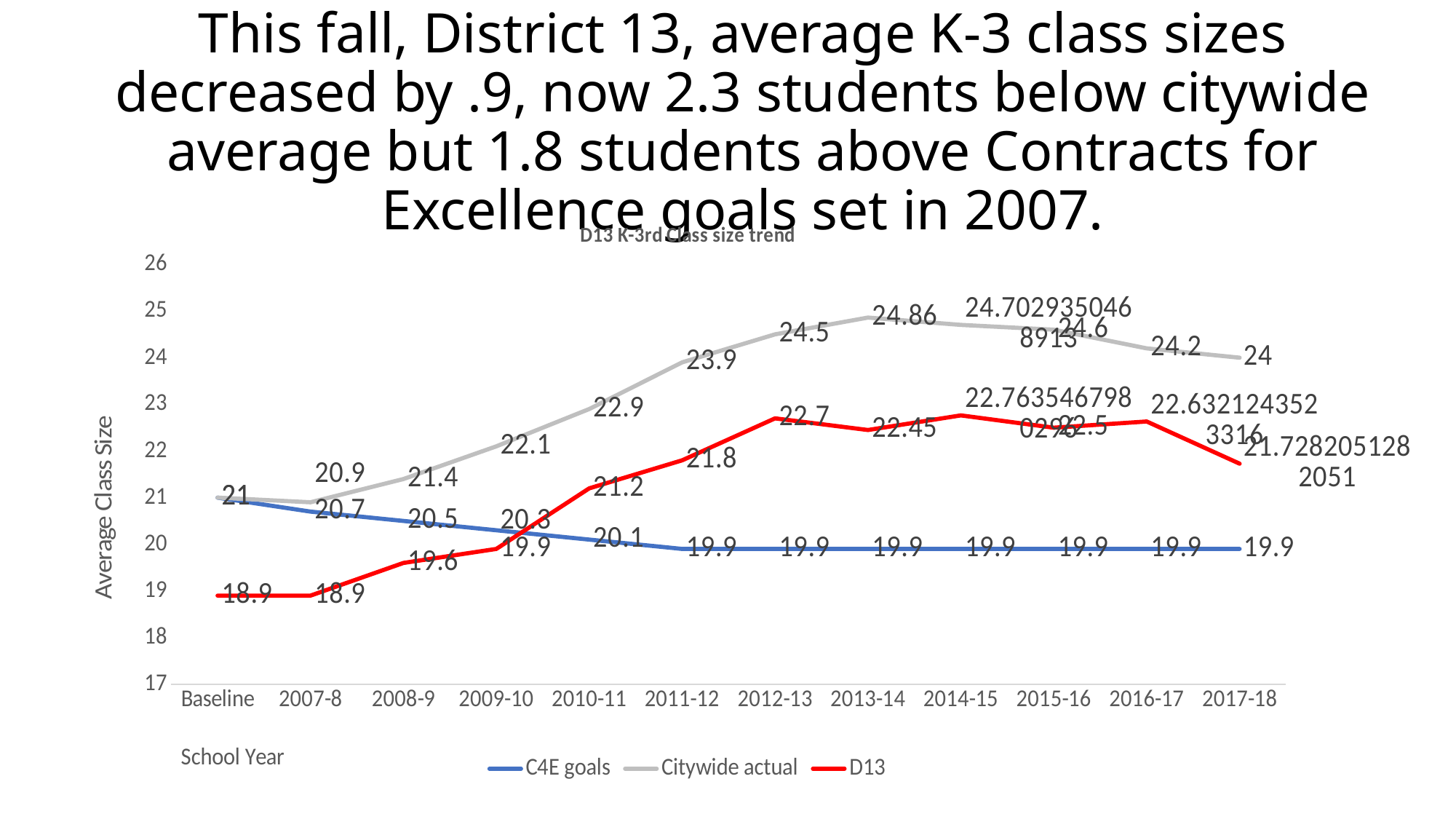
What is the difference between the Citywide actual value and the C4E goals value in 2011-12? 4 Does the D13 line rise or fall from Baseline to 2012-13? rises What is the D13 value for 2012-13? 22.7 What type of chart is shown on the slide? line chart At Baseline, which is larger: the D13 value or the Citywide actual value? Citywide actual In which school year does the Citywide actual series reach its highest value? 2013-14 How many school-year categories are shown on the x axis? 12 What is the D13 value for 2008-9? 19.6 What is the C4E goals value for 2017-18? 19.9 What is the Citywide actual value for 2011-12? 23.9 What colour is the D13 line? red How many series does the legend list? 3